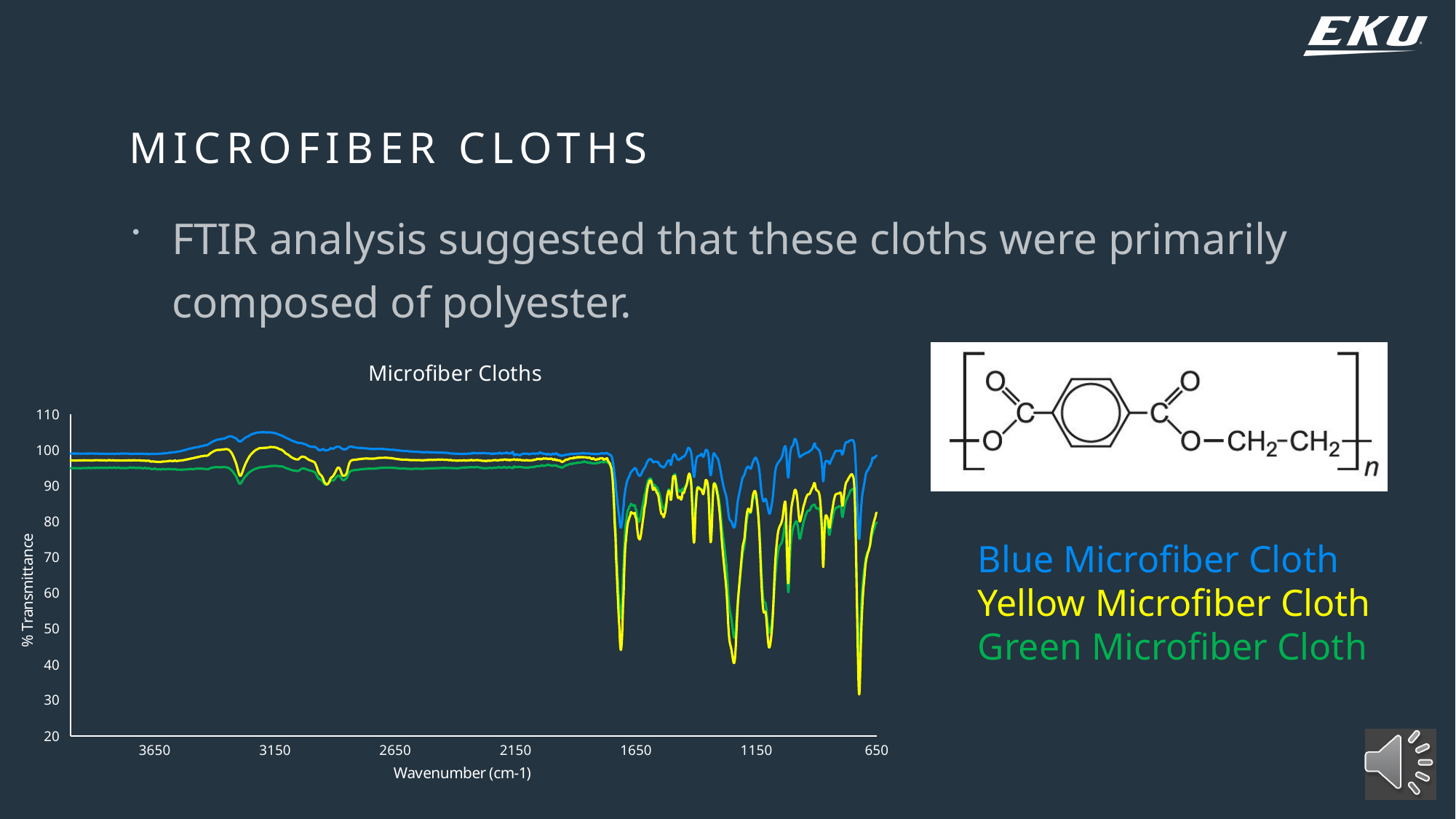
What is the label of the y axis of the chart? % Transmittance Is the value of the Green Microfiber Cloth line at wavenumber 2650 greater or less than 80? greater What kind of chart is shown on the slide? line chart Which series reaches the lowest % Transmittance anywhere on the chart? Yellow Microfiber Cloth How many series (cloths) are plotted on the chart? 3 Is the value of the Blue Microfiber Cloth line at wavenumber 3650 greater or less than 90? greater What is the title of the chart? Microfiber Cloths Is the lowest value reached by the Blue Microfiber Cloth line greater or less than 70? greater Around wavenumber 3150, is the Blue Microfiber Cloth line higher or lower than the Green Microfiber Cloth line? higher Which series has the highest % Transmittance around wavenumber 3150? Blue Microfiber Cloth